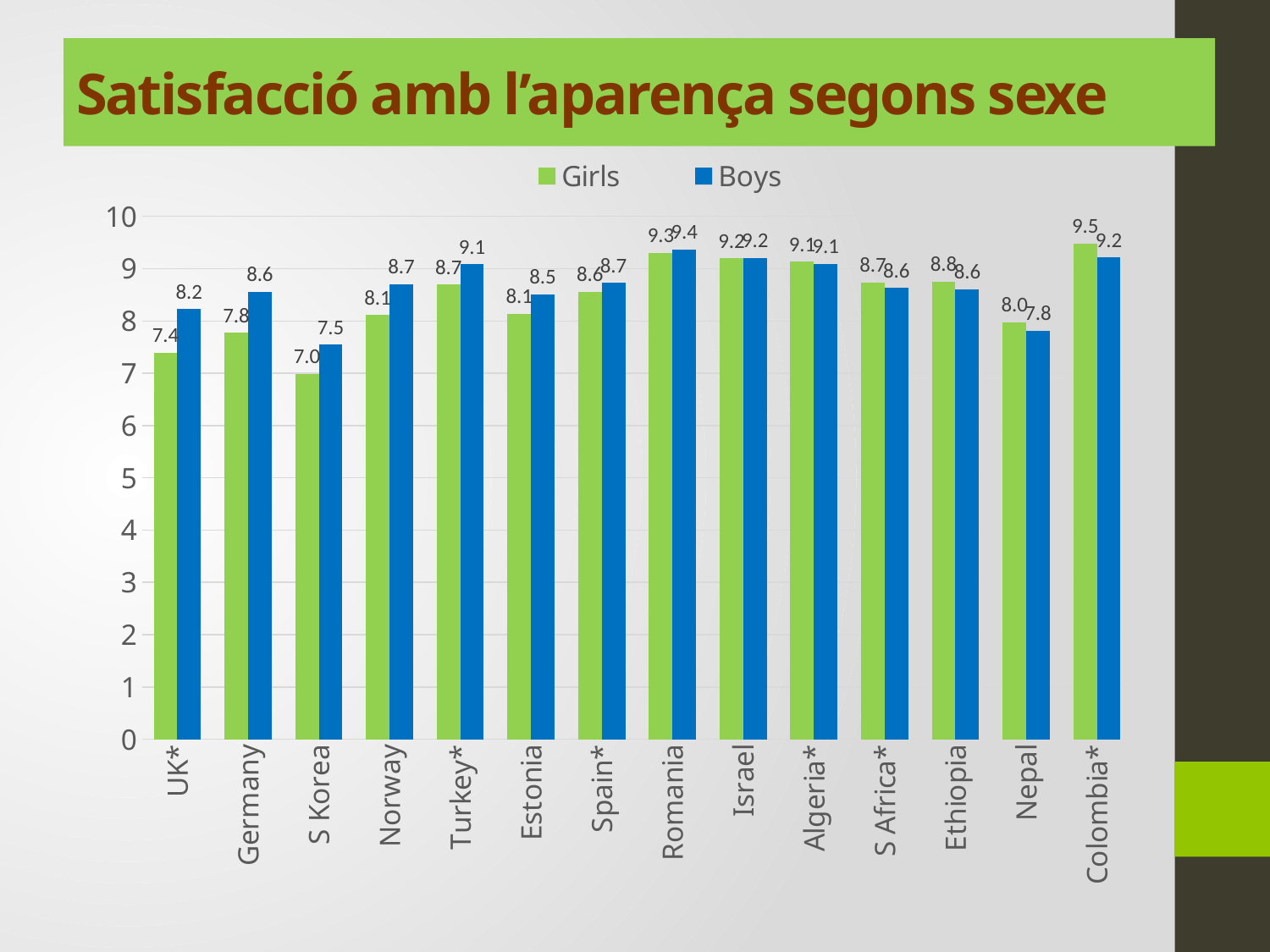
Which country has the lowest Boys value? S Korea Is the Girls value for S Korea greater or less than 8? less What is the Boys value for Germany? 8.6 Which country has the lowest Girls value? S Korea Which country has the highest Girls value? Colombia* What is the Girls value for UK*? 7.4 Which is larger for Nepal, the Girls value or the Boys value? Girls What kind of chart is shown on the slide? bar chart How many series does the legend list? 2 What is the Boys value for Turkey*? 9.1 How many countries are shown on the x axis? 14 What is the difference between the Boys and Girls values for UK*? 0.8